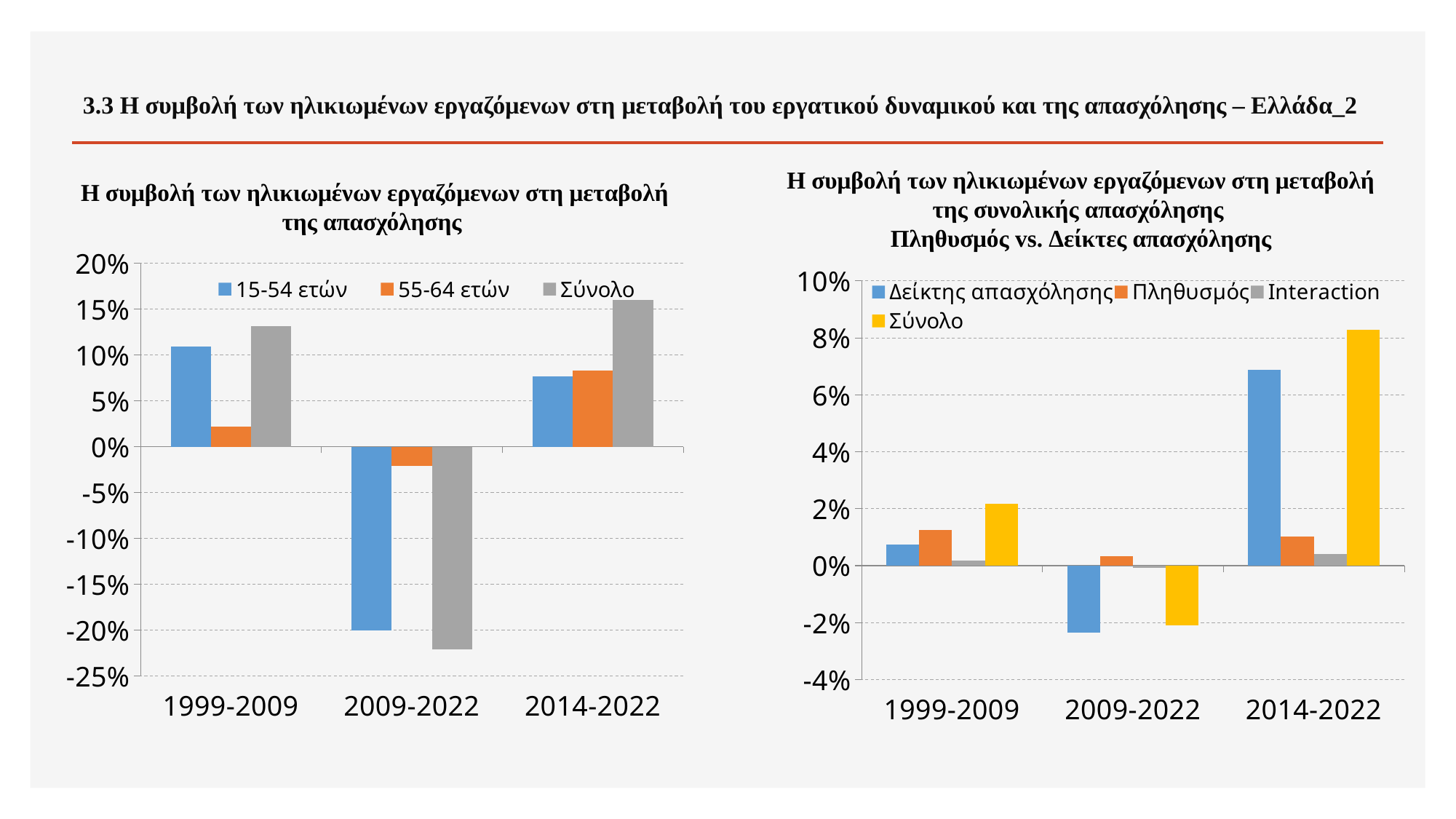
In the left chart, how many periods are shown on the x axis? 3 In the left chart, which period has the highest value for Σύνολο? 2014-2022 In the left chart, for 1999-2009, which is larger: 15-54 ετών or 55-64 ετών? 15-54 ετών In the left chart, is the value for Σύνολο in 2009-2022 greater or less than -20%? less In the right chart, 'Πληθυσμός vs. Δείκτες απασχόλησης', how many series does the legend list? 4 In the right chart, which period has the lowest value for Σύνολο? 2009-2022 In the left chart, is the value for 15-54 ετών in 1999-2009 greater or less than 10%? greater In the right chart, for 1999-2009, which is larger: Πληθυσμός or Δείκτης απασχόλησης? Πληθυσμός What kind of chart is the left chart, 'Η συμβολή των ηλικιωμένων εργαζόμενων στη μεταβολή της απασχόλησης'? Bar chart In the right chart, what colour represents the Σύνολο series? Yellow In the right chart, is the value for Δείκτης απασχόλησης in 2014-2022 greater or less than 6%? greater In the left chart, how many series does the legend list? 3